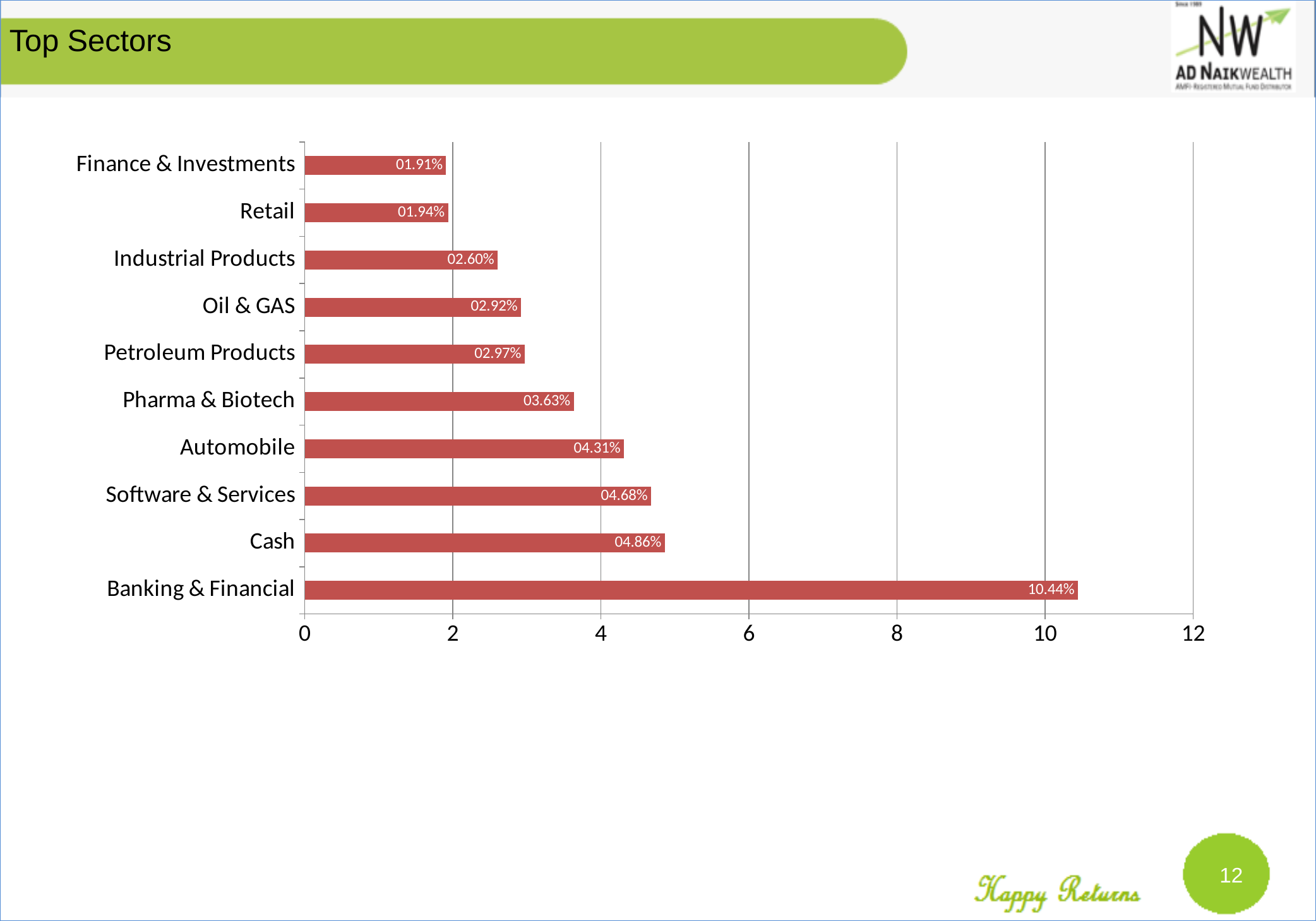
What is the difference between the values for Automobile and Pharma & Biotech? 0.68% Which sector has the lowest value? Finance & Investments Is the value for Automobile greater or less than 4? greater What kind of chart is shown on the slide? bar chart What is the title of the slide containing the chart? Top Sectors Which sector has the highest value? Banking & Financial What is the value for Pharma & Biotech? 03.63% What is the value for Banking & Financial? 10.44% Which is larger, the value for Software & Services or the value for Industrial Products? Software & Services How many sectors are shown in the chart? 10 What is the value for Oil & GAS? 02.92% What is the difference between the values for Banking & Financial and Cash? 5.58%